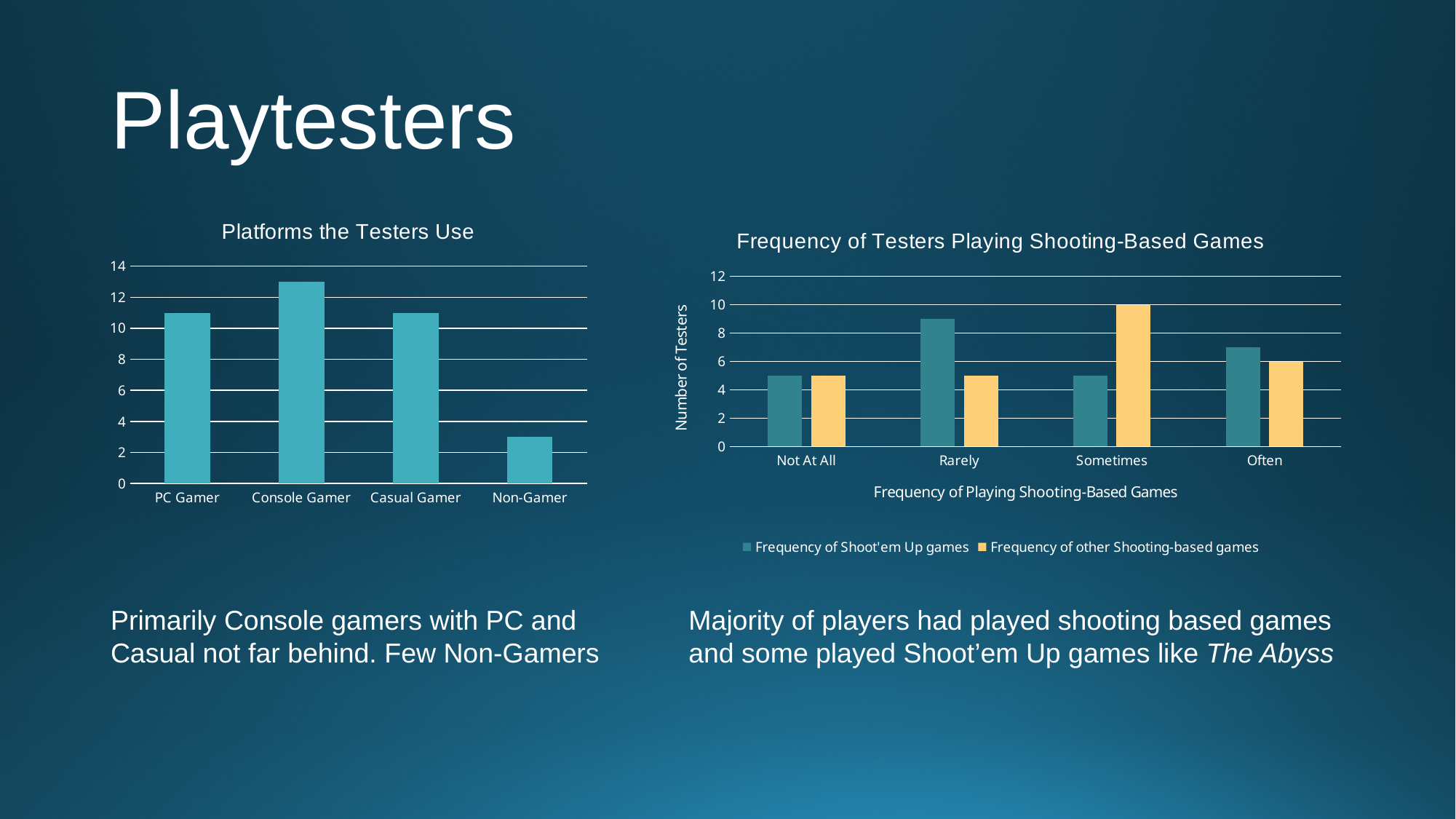
In the 'Platforms the Testers Use' chart, is the value for Non-Gamer greater or less than 4? less In the 'Frequency of Testers Playing Shooting-Based Games' chart, how many series does the legend list? 2 In the 'Frequency of Testers Playing Shooting-Based Games' chart, at Sometimes, which series has the larger value? Frequency of other Shooting-based games In the 'Platforms the Testers Use' chart, which category has the lowest bar? Non-Gamer In the 'Platforms the Testers Use' chart, which category has the highest bar? Console Gamer In the 'Frequency of Testers Playing Shooting-Based Games' chart, what is the label of the y axis? Number of Testers In the 'Platforms the Testers Use' chart, how many categories are shown on the x axis? 4 In the 'Platforms the Testers Use' chart, is the value for Console Gamer greater or less than 12? greater What kind of chart is 'Platforms the Testers Use'? Bar chart In the 'Frequency of Testers Playing Shooting-Based Games' chart, what is the value for 'Frequency of other Shooting-based games' at Sometimes? 10 In the 'Frequency of Testers Playing Shooting-Based Games' chart, what is the value for 'Frequency of other Shooting-based games' at Often? 6 In the 'Frequency of Testers Playing Shooting-Based Games' chart, which category has the highest bar for 'Frequency of Shoot'em Up games'? Rarely